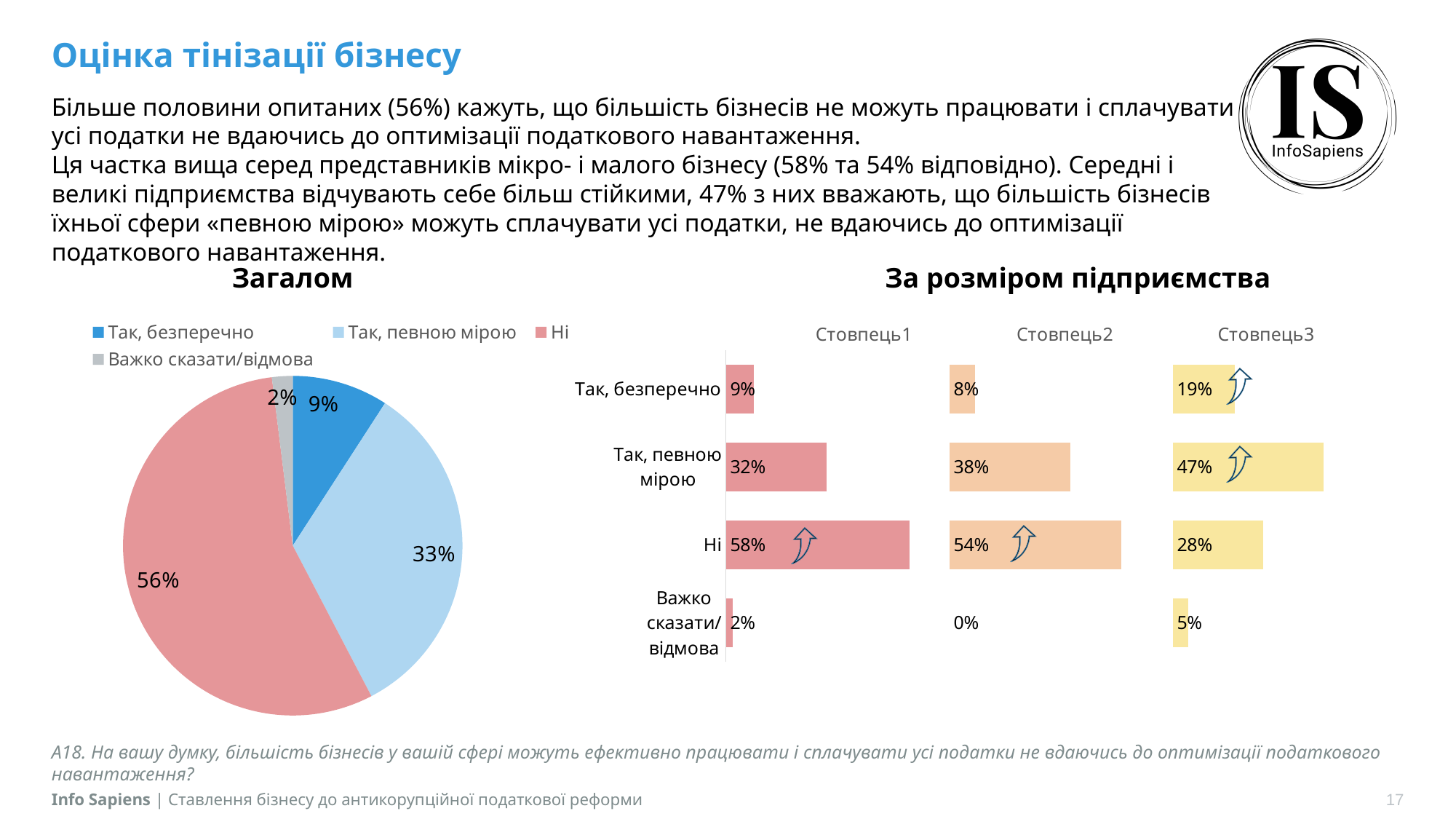
In the pie chart 'Загалом', what share is labelled for 'Ні'? 56% In the bar chart 'За розміром підприємства', what is the value for 'Так, певною мірою' in Стовпець3? 47% In the bar chart 'За розміром підприємства', which category has the highest value in Стовпець3? Так, певною мірою In the pie chart 'Загалом', what share is labelled for 'Так, певною мірою'? 33% In the pie chart 'Загалом', which category has the smallest slice? Важко сказати/відмова What type of chart is the chart titled 'Загалом'? Pie chart In the pie chart 'Загалом', which category has the largest slice? Ні In the bar chart 'За розміром підприємства', what is the value for 'Ні' in Стовпець1? 58% In the pie chart 'Загалом', how many categories does the legend list? 4 In the bar chart 'За розміром підприємства', what is the value for 'Важко сказати/відмова' in Стовпець2? 0% In the bar chart 'За розміром підприємства', what is the difference between 'Ні' in Стовпець1 and 'Ні' in Стовпець3? 30% In the bar chart 'За розміром підприємства', which is larger: 'Так, безперечно' in Стовпець3 or 'Так, безперечно' in Стовпець2? Стовпець3